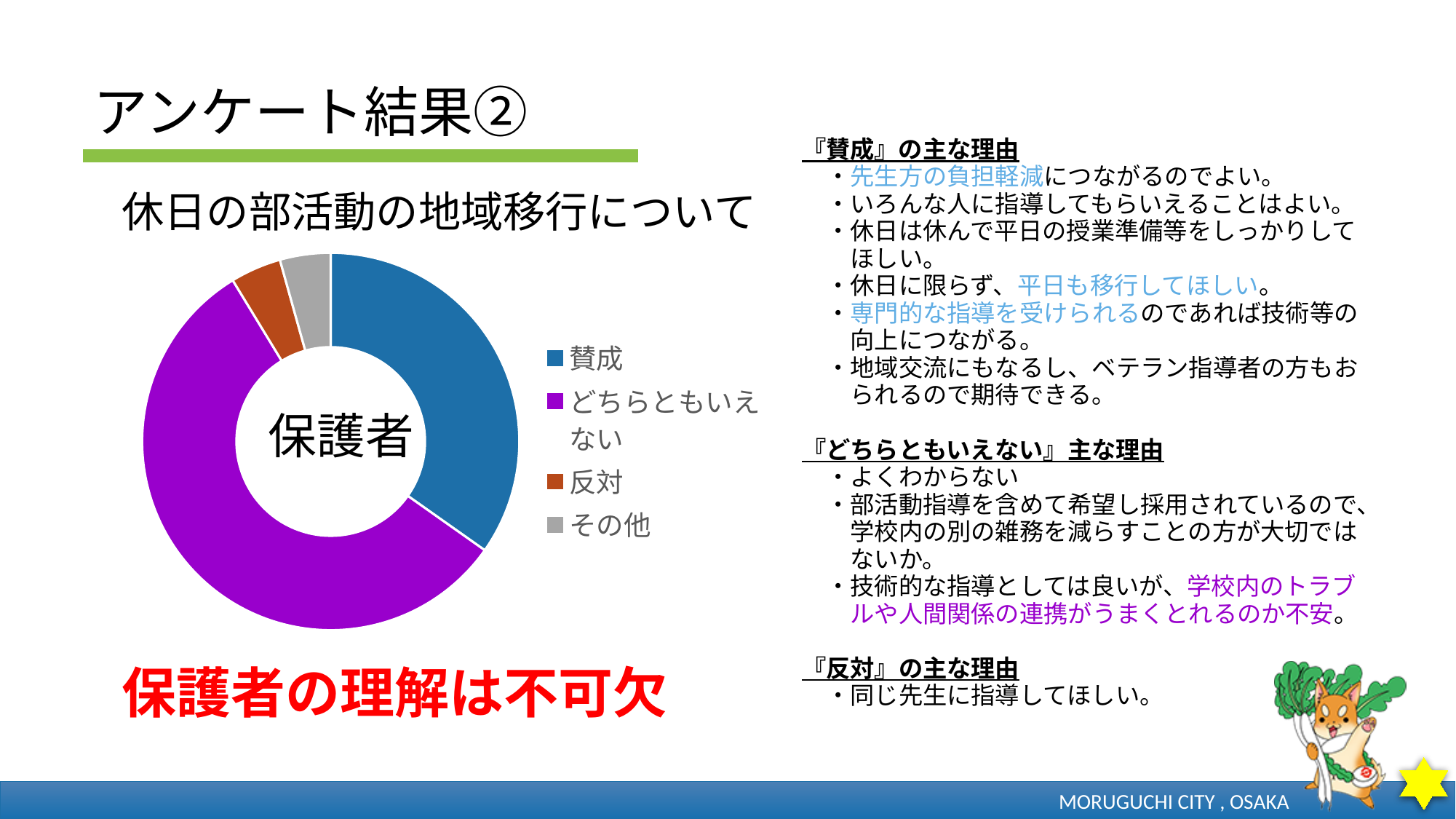
Which category is shown in blue in the chart? 賛成 Which is larger in the chart, 賛成 or どちらともいえない? どちらともいえない Which is larger in the chart, どちらともいえない or その他? どちらともいえない What is the title of the chart? 休日の部活動の地域移行について How many categories does the chart's legend list? 4 Which category has the largest share of the doughnut chart? どちらともいえない What label is written in the centre of the doughnut chart? 保護者 What kind of chart is shown on the slide? Doughnut (pie) chart Which is larger in the chart, 賛成 or 反対? 賛成